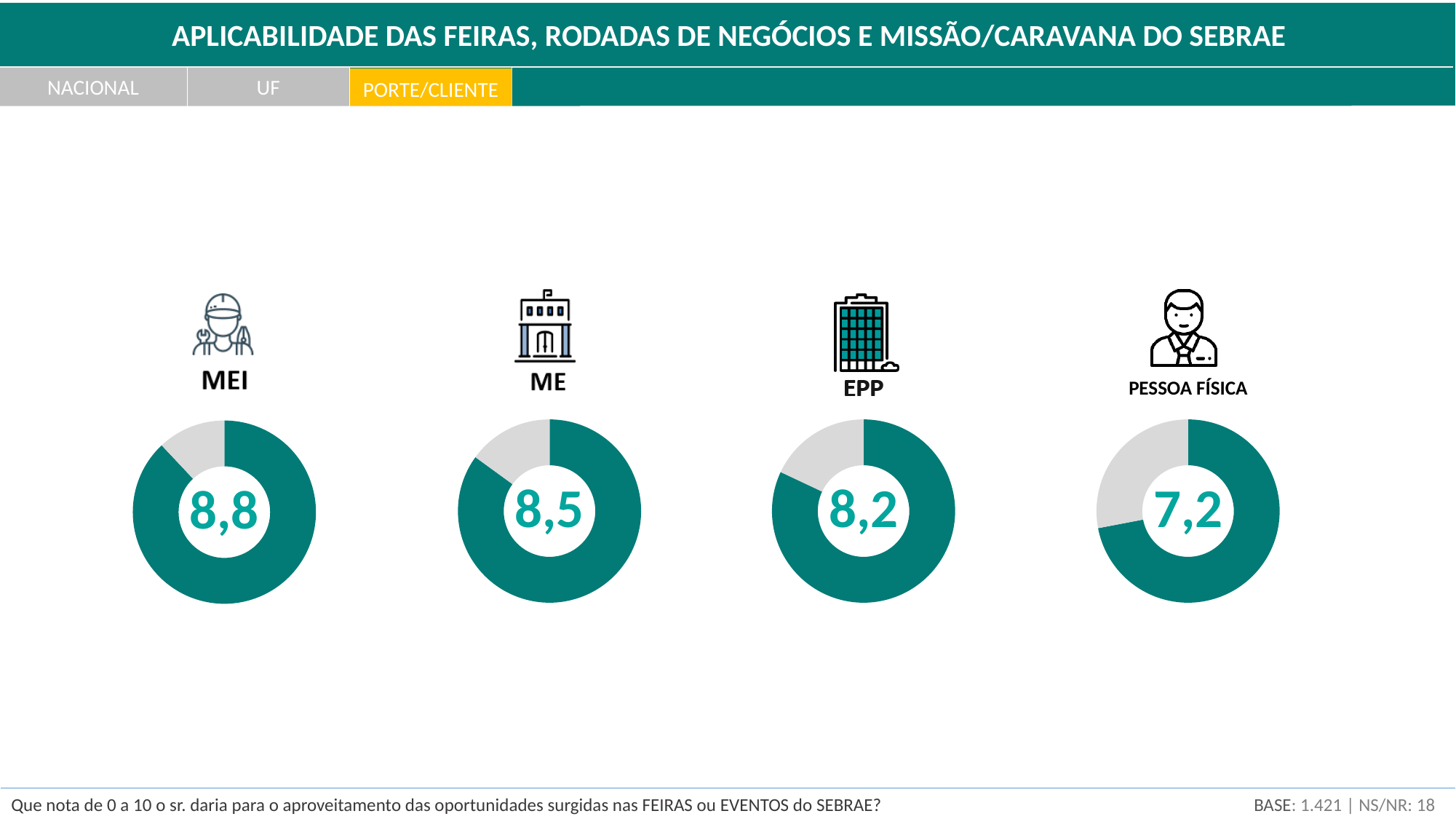
What kind of chart is used to display each group's score? Donut chart What is the score shown in the ME donut chart? 8,5 What is the score shown in the EPP donut chart? 8,2 What is the difference between the MEI score and the PESSOA FÍSICA score? 1,6 How many donut charts are shown on the slide? 4 What is the difference between the ME score and the EPP score? 0,3 Which has a higher score, ME or EPP? ME What is the score shown in the MEI donut chart? 8,8 Which tab is highlighted in yellow at the top of the slide? PORTE/CLIENTE Which group has the lowest score among the four donut charts? PESSOA FÍSICA Which group has the highest score among the four donut charts? MEI What is the score shown in the PESSOA FÍSICA donut chart? 7,2